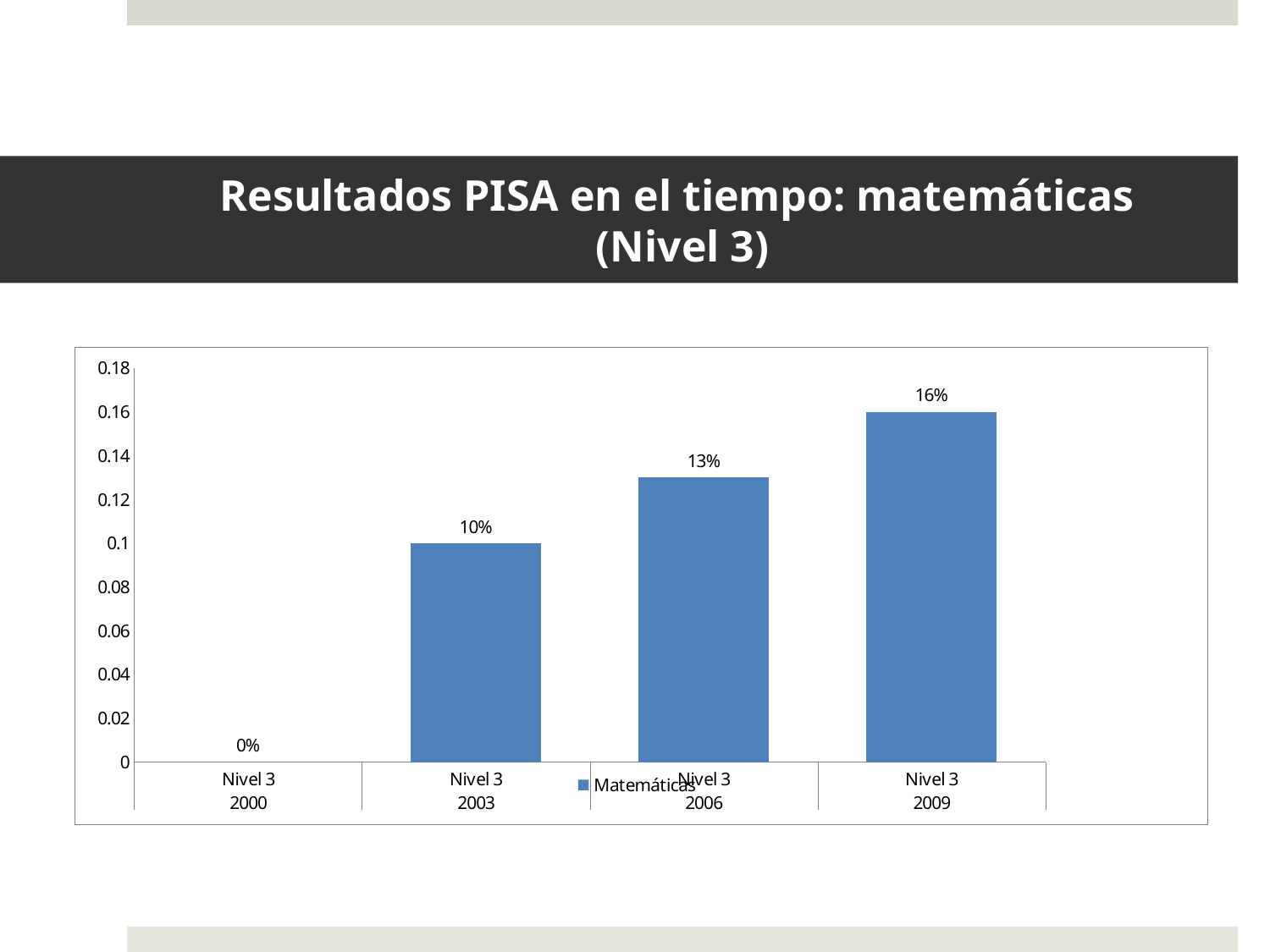
What kind of chart is shown on the slide? Bar chart What is the value for Nivel 3 2009? 16% Do the values rise or fall from 2000 to 2009? Rise What series name does the legend show? Matemáticas Which category has the highest value? Nivel 3 2009 What is the value for Nivel 3 2000? 0% How many categories are shown on the x axis? 4 Which is larger, the value for Nivel 3 2006 or Nivel 3 2003? Nivel 3 2006 Which category has the lowest value? Nivel 3 2000 What is the difference between the values for Nivel 3 2009 and Nivel 3 2003? 6% What is the value for Nivel 3 2003? 10% What is the value for Nivel 3 2006? 13%